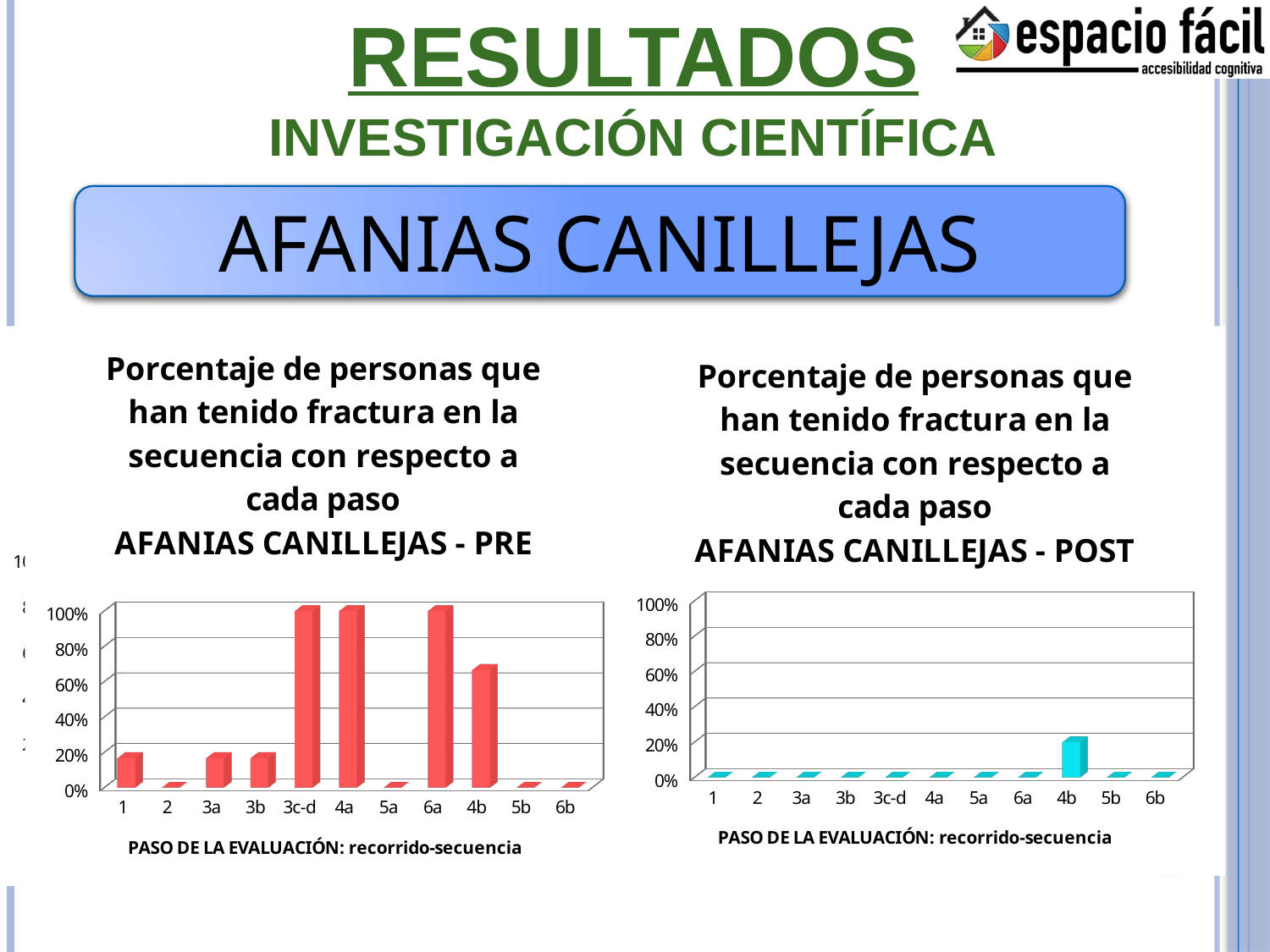
In the 'AFANIAS CANILLEJAS - PRE' chart, what is the value for step 3c-d? 100% In the 'AFANIAS CANILLEJAS - PRE' chart, is the value for step 4b greater or less than 40%? greater In the 'AFANIAS CANILLEJAS - POST' chart, is the value for step 4b greater or less than 40%? less In the 'AFANIAS CANILLEJAS - PRE' chart, which is larger, the value for step 4b or the value for step 3a? 4b What is the x-axis title of the 'AFANIAS CANILLEJAS - POST' chart? PASO DE LA EVALUACIÓN: recorrido-secuencia What kind of chart is the 'AFANIAS CANILLEJAS - PRE' chart on the left? bar chart How many categories are shown on the x axis of the 'AFANIAS CANILLEJAS - POST' chart? 11 In the 'AFANIAS CANILLEJAS - PRE' chart, which is larger, the value for step 4a or the value for step 4b? 4a In the 'AFANIAS CANILLEJAS - POST' chart on the right, which step has the highest value? 4b In the 'AFANIAS CANILLEJAS - PRE' chart, is the value for step 1 greater or less than 40%? less In the 'AFANIAS CANILLEJAS - PRE' chart, what is the value for step 2? 0% How many categories are shown on the x axis of the 'AFANIAS CANILLEJAS - PRE' chart? 11